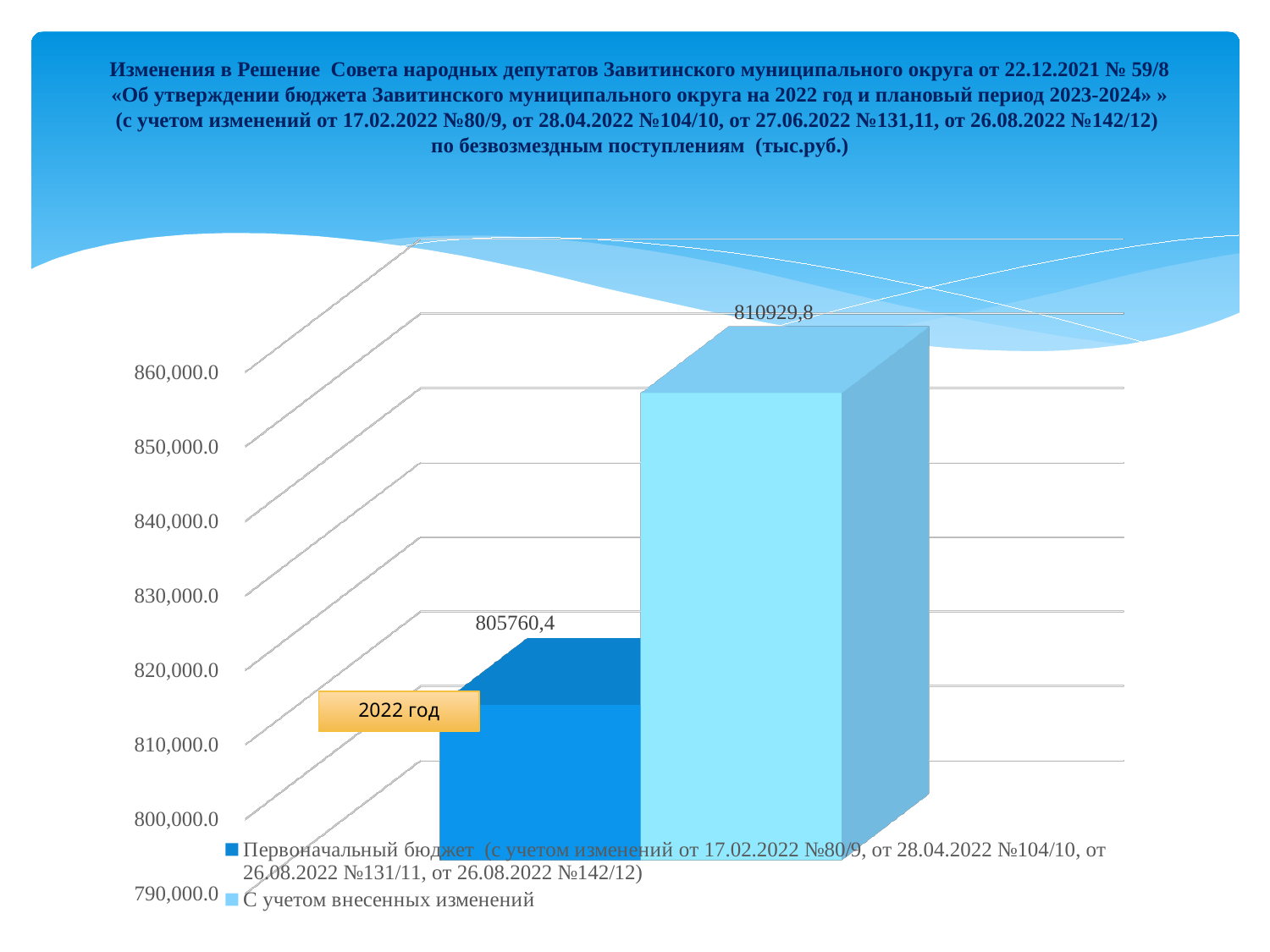
What is the value of the 'С учетом внесенных изменений' bar? 810929,8 Is the value for 'Первоначальный бюджет' greater or less than 830,000.0? less How many series does the legend list? 2 Which year is labelled on the chart's category? 2022 год Which series has the higher value: 'Первоначальный бюджет' or 'С учетом внесенных изменений'? С учетом внесенных изменений Which series shows the lowest value on the chart? Первоначальный бюджет What is the value of the 'Первоначальный бюджет' bar? 805760,4 What type of chart is shown on the slide? Bar chart How many bars are plotted on the chart? 2 What unit of measurement is stated in the chart title? тыс.руб. What is the difference between the 'С учетом внесенных изменений' value and the 'Первоначальный бюджет' value? 5169,4